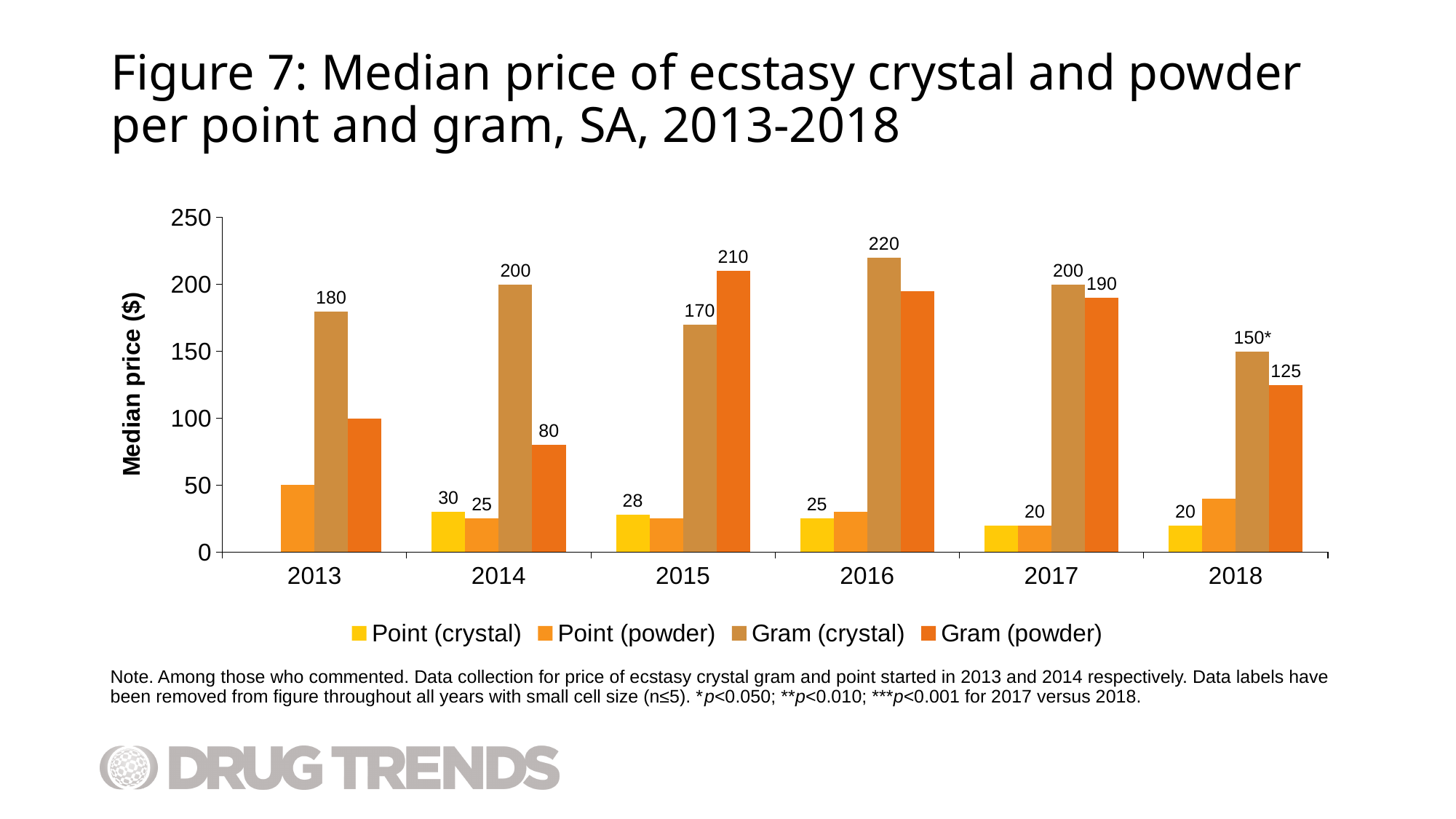
How many series does the legend list? 4 What is the median price for Gram (powder) in 2015? 210 In which year is the Gram (crystal) median price highest? 2016 What is the data label shown for Gram (crystal) in 2018? 150* What is the difference between the Gram (crystal) and Gram (powder) median prices in 2014? 120 What is the median price for Point (crystal) in 2014? 30 In 2015, which is higher: Gram (crystal) or Gram (powder)? Gram (powder) What kind of chart is shown on the slide? Bar chart What is the median price for Gram (crystal) in 2016? 220 Is the value for Point (powder) in 2018 greater or less than 50? less Is the value for Gram (powder) in 2016 greater or less than 150? greater How many years are shown on the x axis? 6